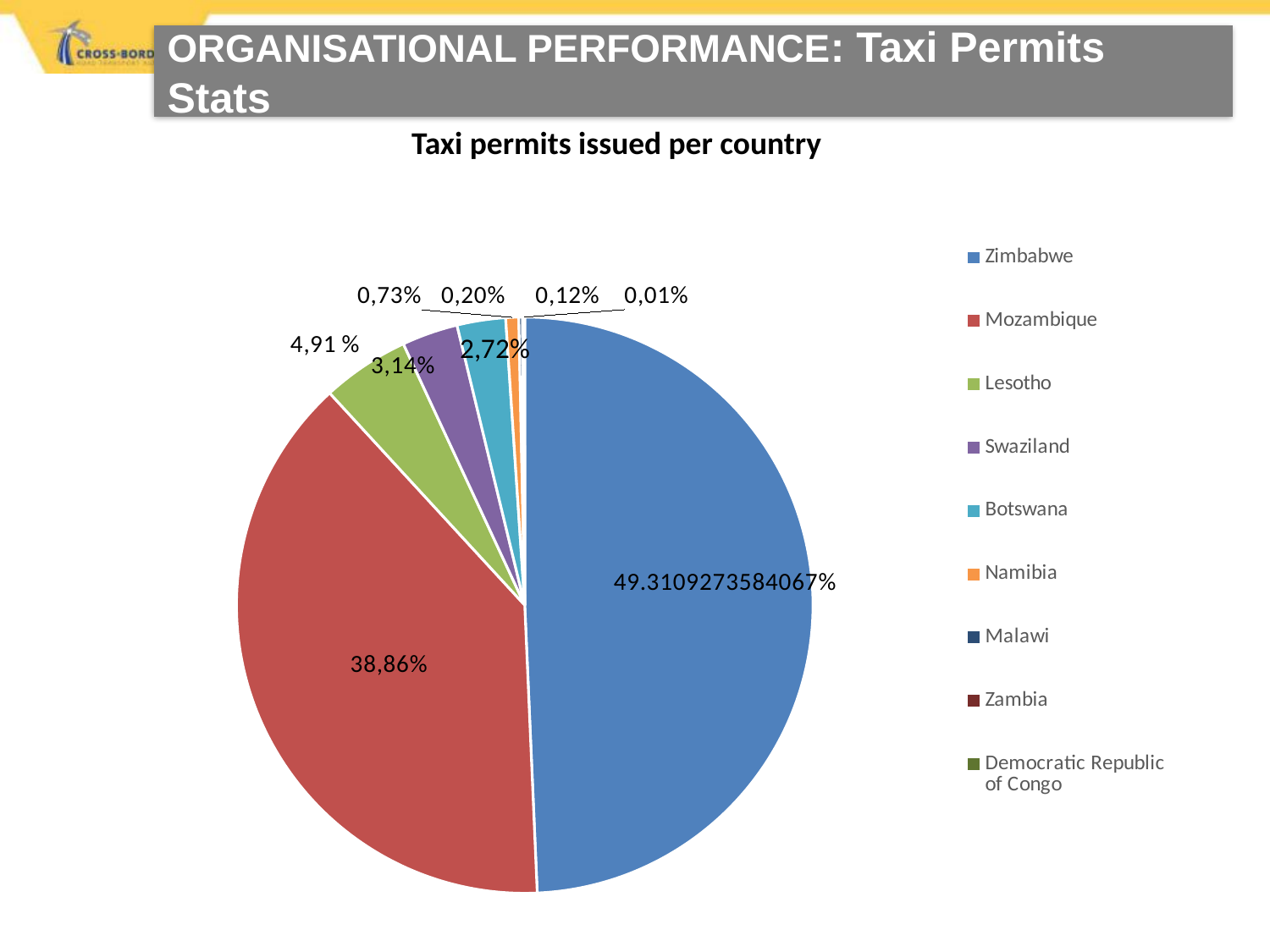
What is the title of the chart? Taxi permits issued per country What percentage of taxi permits is shown for Botswana? 2,72% What is the difference in percentage points between Mozambique's share and Lesotho's share? 33,95% What percentage of taxi permits is shown for Namibia? 0,73% What percentage of taxi permits is shown for Mozambique? 38,86% What percentage of taxi permits is shown for Swaziland? 3,14% Which colour represents Zimbabwe in the pie chart? Blue Which country has the largest share of taxi permits issued? Zimbabwe What percentage of taxi permits is shown for Lesotho? 4,91 % Which has a larger share of taxi permits, Lesotho or Swaziland? Lesotho What type of chart is shown on the slide? Pie chart How many countries are listed in the chart legend? 9